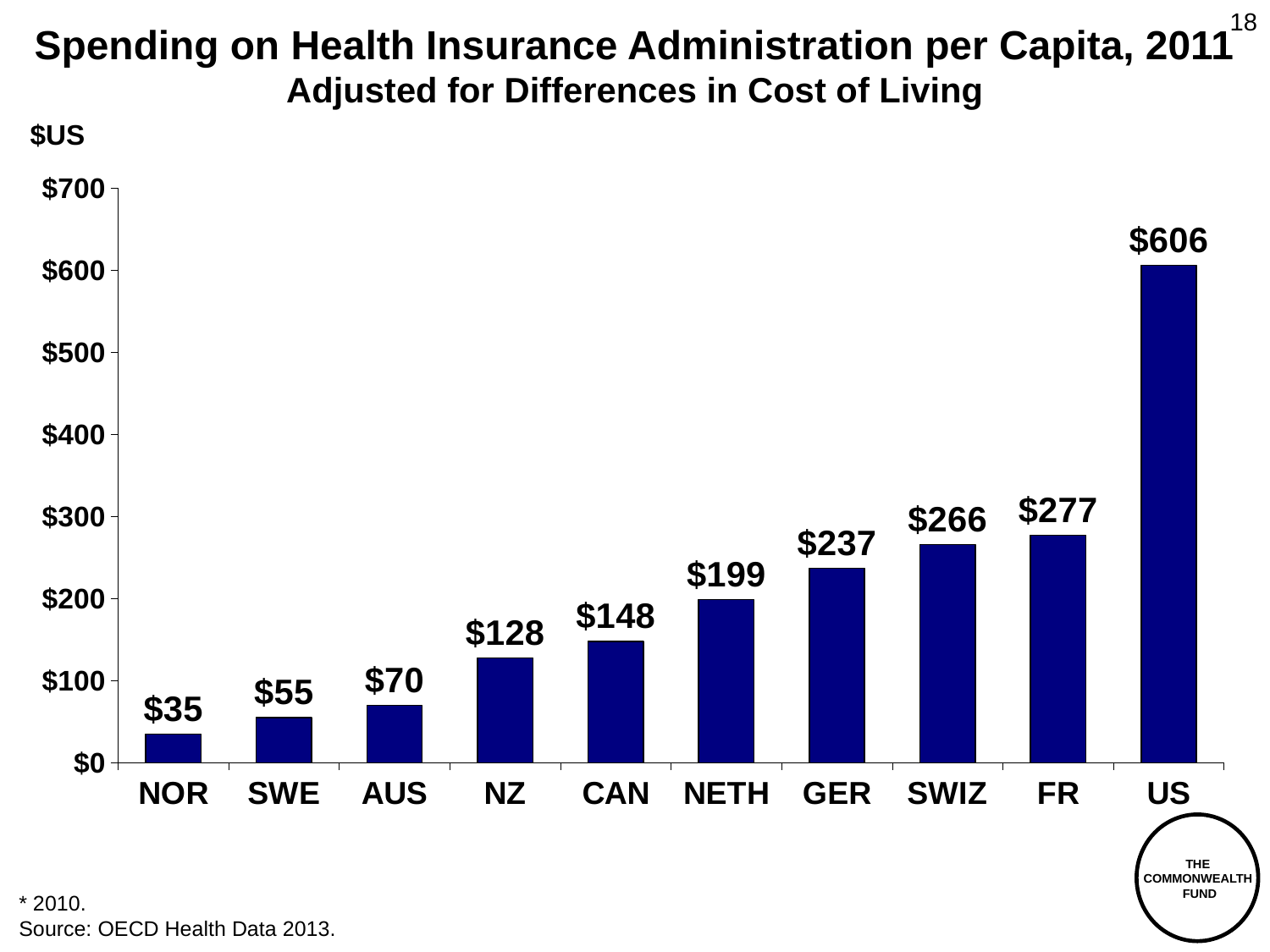
What is the difference between the values for SWIZ and NETH? $67 Which is larger, the value for NZ or the value for AUS? NZ Do the values rise or fall from left to right across the countries? rise How many countries are shown on the chart? 10 Is the value for SWE greater or less than $100? less What kind of chart is shown on the slide? bar chart Which country has the lowest spending on health insurance administration per capita? NOR What is the value shown for NOR? $35 What is the difference between the values for US and FR? $329 Which country has the highest spending on health insurance administration per capita? US What is the spending on health insurance administration per capita for CAN? $148 What is the value shown for GER? $237